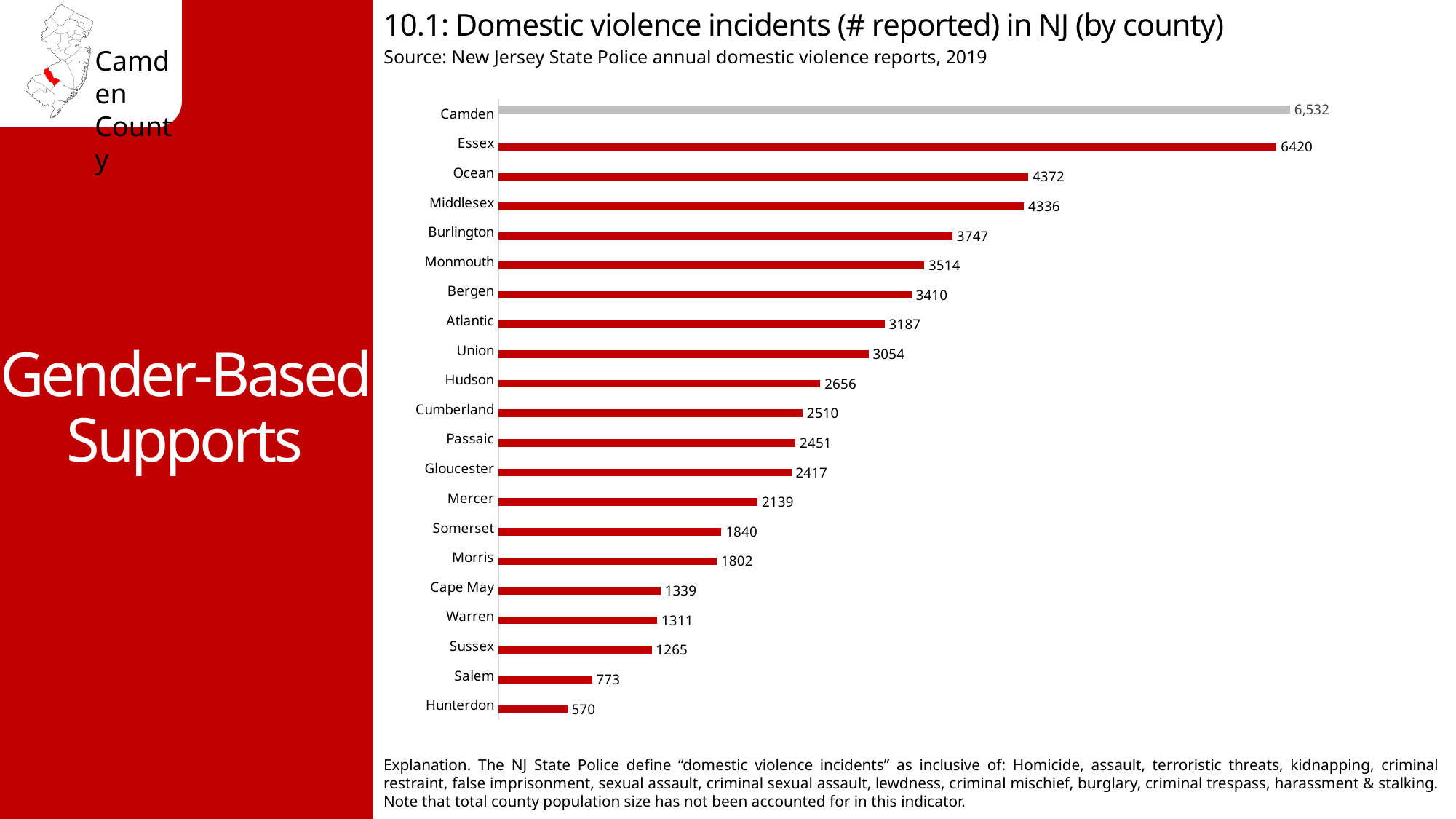
What is the difference between the number of incidents for Ocean and Middlesex? 36 Which county has more reported incidents, Burlington or Monmouth? Burlington What kind of chart is shown on the slide? Bar chart Which county's bar is shown in a different colour (grey) from the others? Camden Which county has more reported incidents, Salem or Sussex? Sussex What is the number of reported domestic violence incidents for Camden? 6,532 Which county has the lowest number of reported domestic violence incidents? Hunterdon How many counties are shown in the chart? 21 What is the number of reported domestic violence incidents for Hunterdon? 570 What is the number of reported domestic violence incidents for Essex? 6420 Which county has the highest number of reported domestic violence incidents? Camden What is the difference between the number of incidents for Camden and Essex? 112